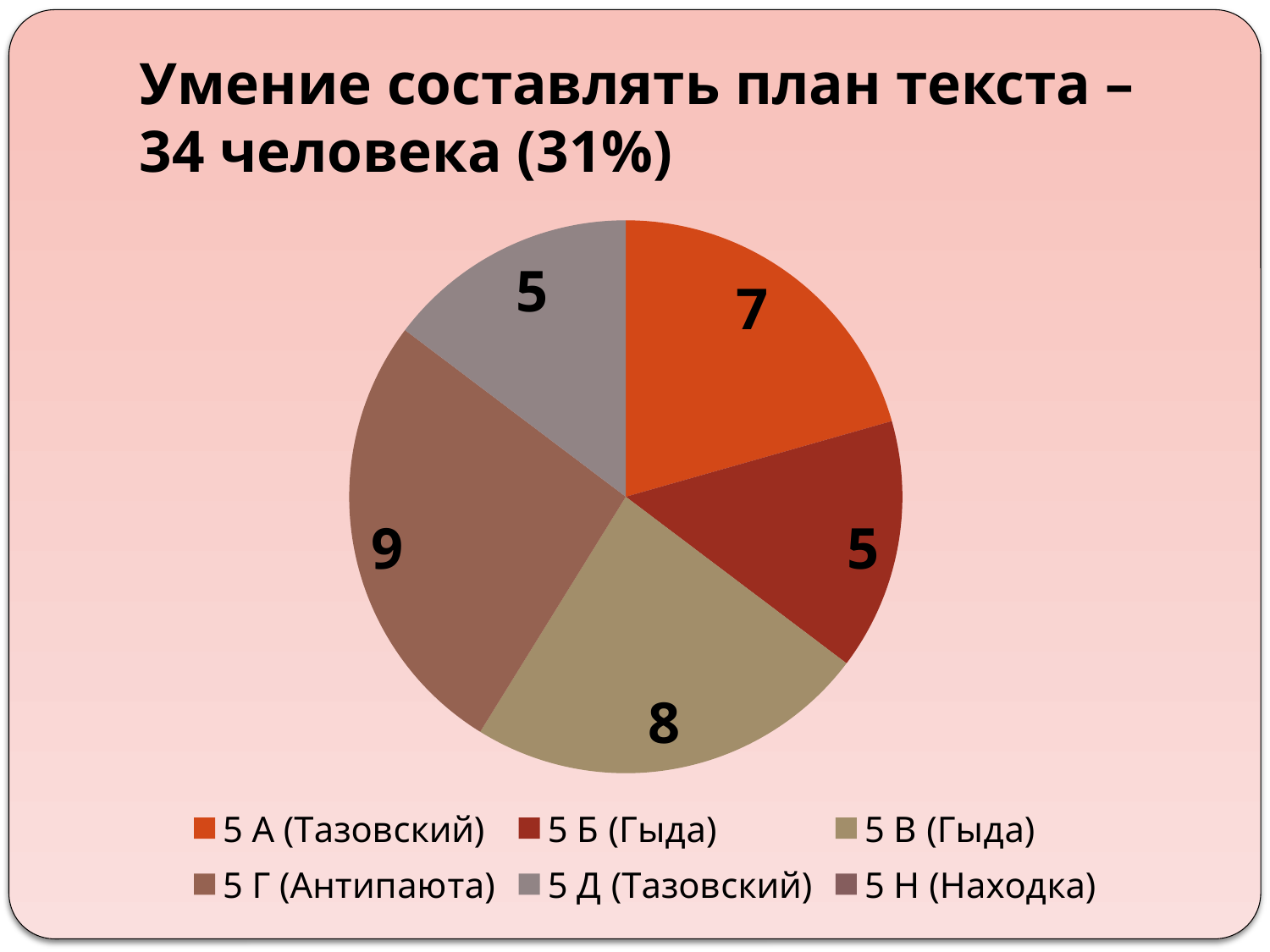
What is the difference between the values for 5 Г (Антипаюта) and 5 А (Тазовский)? 2 How many slices are visible in the pie? 5 What is the value for 5 Г (Антипаюта)? 9 What is the title of the chart? Умение составлять план текста – 34 человека (31%) What is the value for 5 В (Гыда)? 8 What is the value for 5 Д (Тазовский)? 5 Which category has the largest slice of the pie? 5 Г (Антипаюта) What is the value for 5 Б (Гыда)? 5 How many entries does the legend list? 6 What is the value for 5 А (Тазовский)? 7 Which is larger, the value for 5 В (Гыда) or the value for 5 А (Тазовский)? 5 В (Гыда) What kind of chart is shown on the slide? pie chart